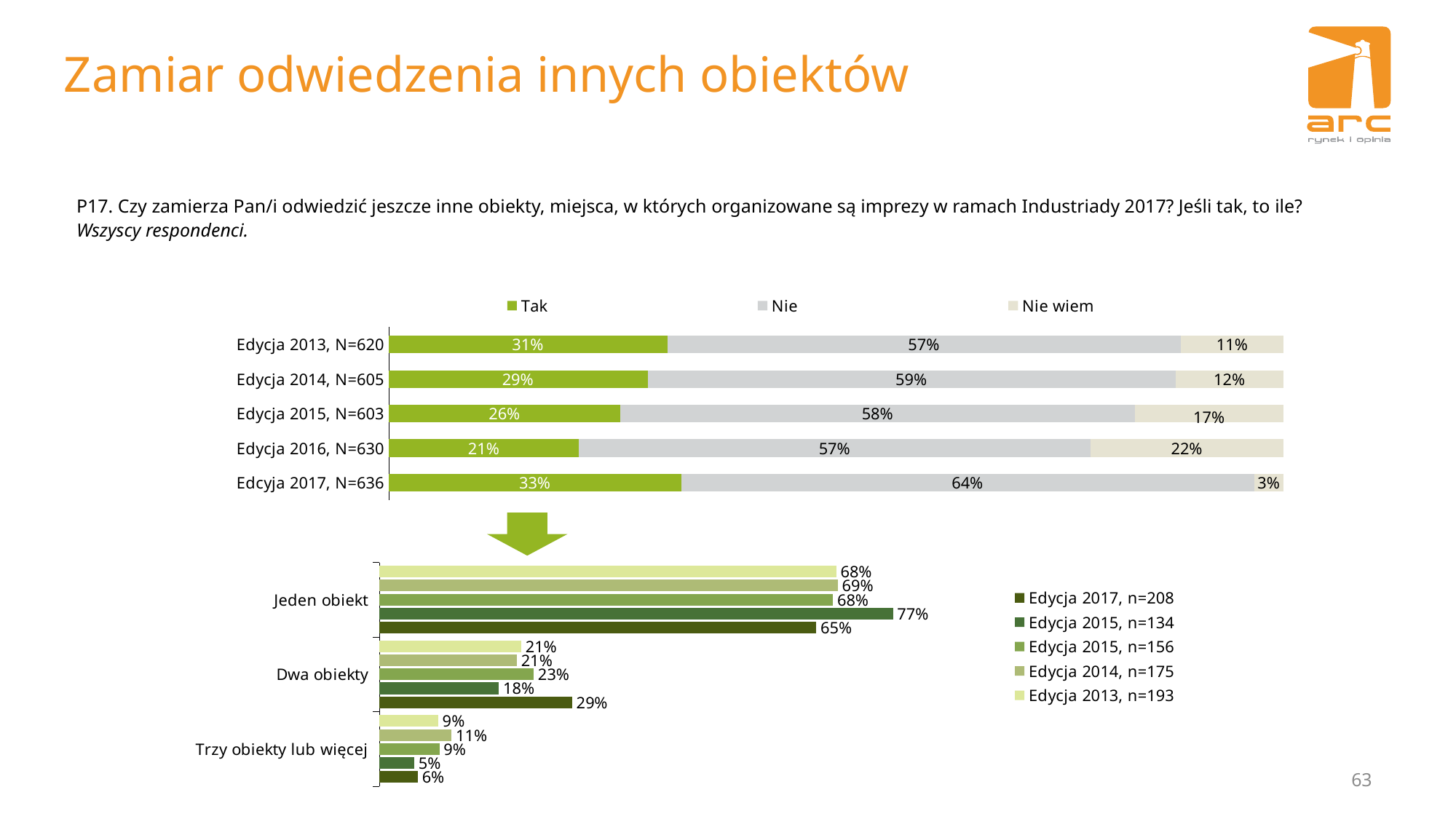
What type of chart is the bottom chart on the slide? Bar chart In the top stacked bar chart, what is the difference between the "Nie wiem" shares for Edycja 2016, N=630 and Edycja 2013, N=620? 11 percentage points How many series does the legend of the top stacked bar chart list? 3 In the top stacked bar chart, what percentage answered "Nie" in Edcyja 2017, N=636? 64% In the top stacked bar chart, is the "Tak" share larger for Edycja 2014, N=605 or Edycja 2015, N=603? Edycja 2014, N=605 In the bottom bar chart, what percentage of Edycja 2013, n=193 respondents intend to visit "Jeden obiekt"? 68% In the top stacked bar chart, which edition has the lowest "Nie wiem" share? Edcyja 2017, N=636 In the bottom bar chart, what is the difference between the "Trzy obiekty lub więcej" values for Edycja 2014, n=175 and Edycja 2017, n=208? 5 percentage points In the bottom bar chart, what percentage of Edycja 2017, n=208 respondents intend to visit "Dwa obiekty"? 29% In the top stacked bar chart, which edition has the highest "Tak" share? Edcyja 2017, N=636 In the top stacked bar chart, what percentage answered "Tak" in Edycja 2016, N=630? 21% How many editions (categories) are shown in the top stacked bar chart? 5